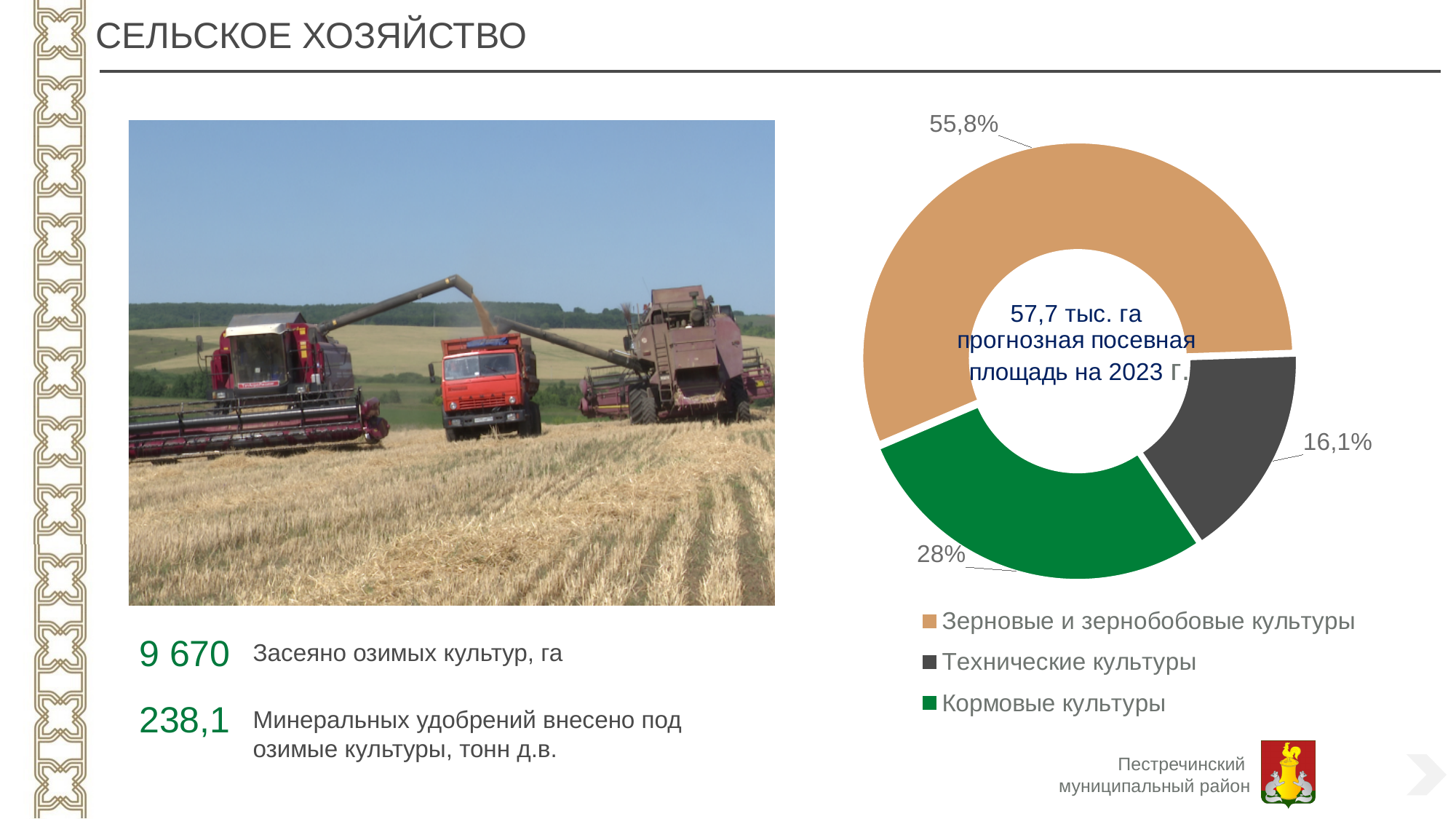
Which crop category has the smallest share in the donut chart? Технические культуры How many crop categories are shown in the donut chart? 3 Which crop category has the largest share in the donut chart? Зерновые и зернобобовые культуры What is the combined share of Зерновые и зернобобовые культуры and Технические культуры? 71,9% What share of the forecast sown area is taken by Кормовые культуры? 28% What share of the forecast sown area is taken by Технические культуры? 16,1% What kind of chart is used to show the crop structure on the slide? Donut (pie) chart What share of the forecast sown area is taken by Зерновые и зернобобовые культуры? 55,8% What total forecast sown area for 2023 is stated in the centre of the donut chart? 57,7 тыс. га Which has a larger share: Кормовые культуры or Технические культуры? Кормовые культуры What is the difference in percentage points between the shares of Кормовые культуры and Технические культуры? 11,9 Which colour represents Кормовые культуры in the donut chart? Green